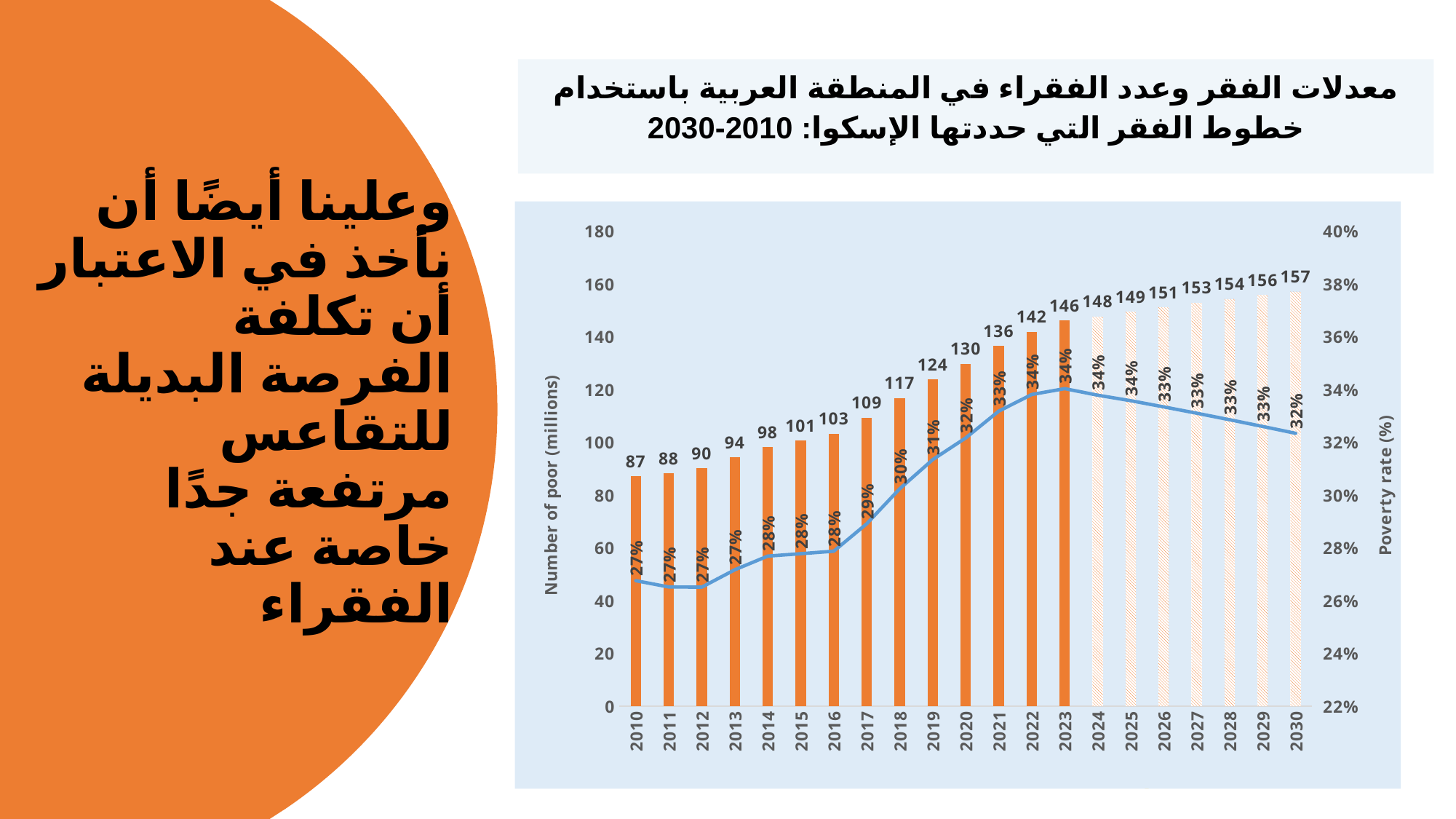
What is the label of the left vertical axis? Number of poor (millions) What is the label of the right vertical axis? Poverty rate (%) Which is larger, the number of poor in 2017 or in 2020? 2020 What is the number of poor (millions) shown for 2010? 87 What poverty rate is labelled for 2019? 31% How many years are shown on the x axis? 21 By how many millions does the number of poor in 2030 exceed that in 2010? 70 Which year has the highest number of poor (millions)? 2030 What is the number of poor (millions) shown for 2023? 146 Which year has the lowest number of poor (millions)? 2010 What is the highest poverty rate labelled on the chart? 34% Does the number of poor rise or fall from 2010 to 2030? rise